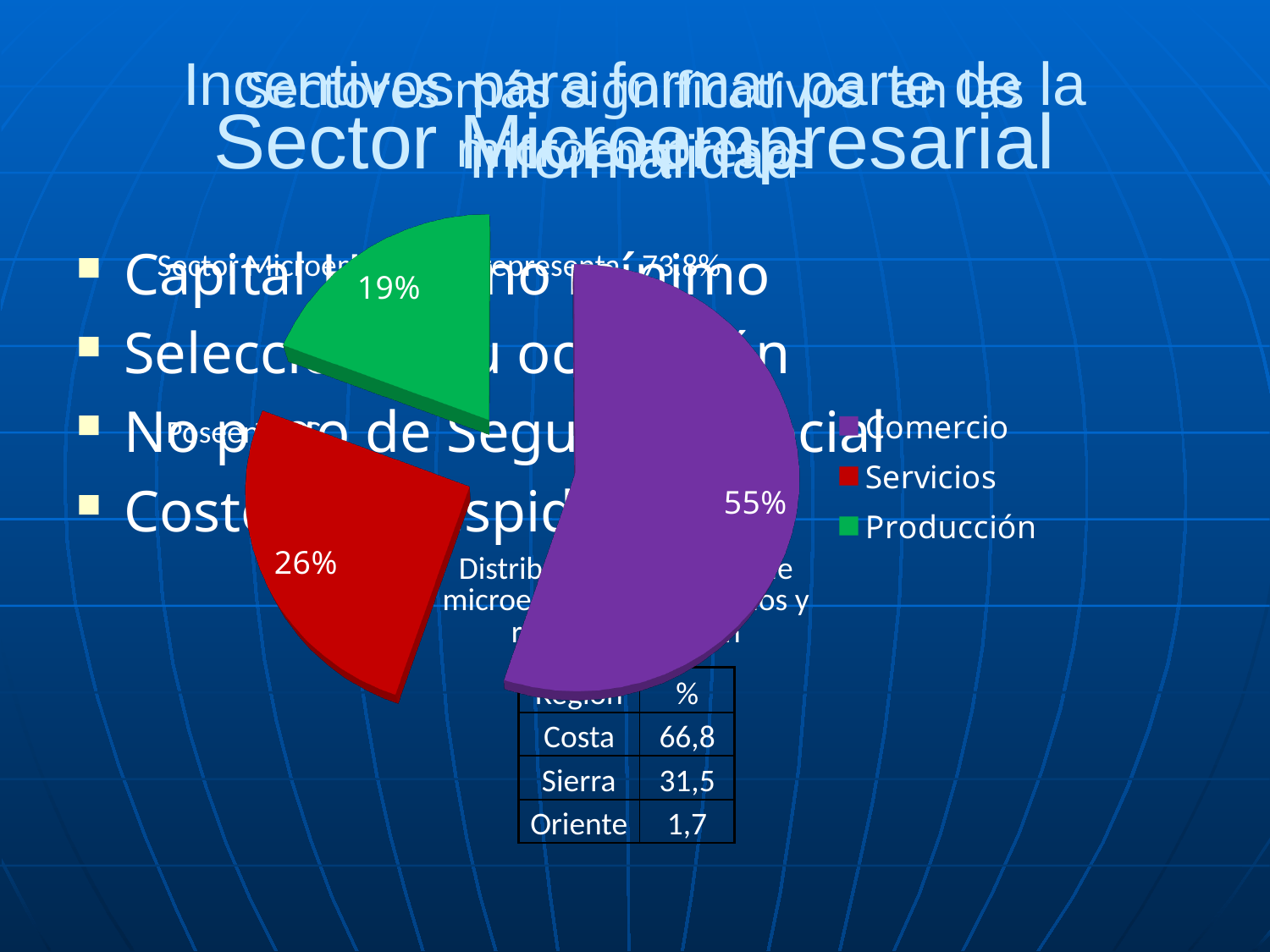
How many entries does the pie chart legend list? 3 Which slice is larger, Servicios or Producción? Servicios What percentage of the pie chart does Comercio represent? 55% What colour is the Comercio slice in the pie chart? purple What percentage of the pie chart does Servicios represent? 26% What type of chart is shown on the slide? pie chart What percentage of the pie chart does Producción represent? 19% Which category has the smallest slice in the pie chart? Producción What is the difference in percentage points between the Comercio and Servicios slices? 29 Which category has the largest slice in the pie chart? Comercio How many slices does the pie chart have? 3 What is the difference in percentage points between the Servicios and Producción slices? 7